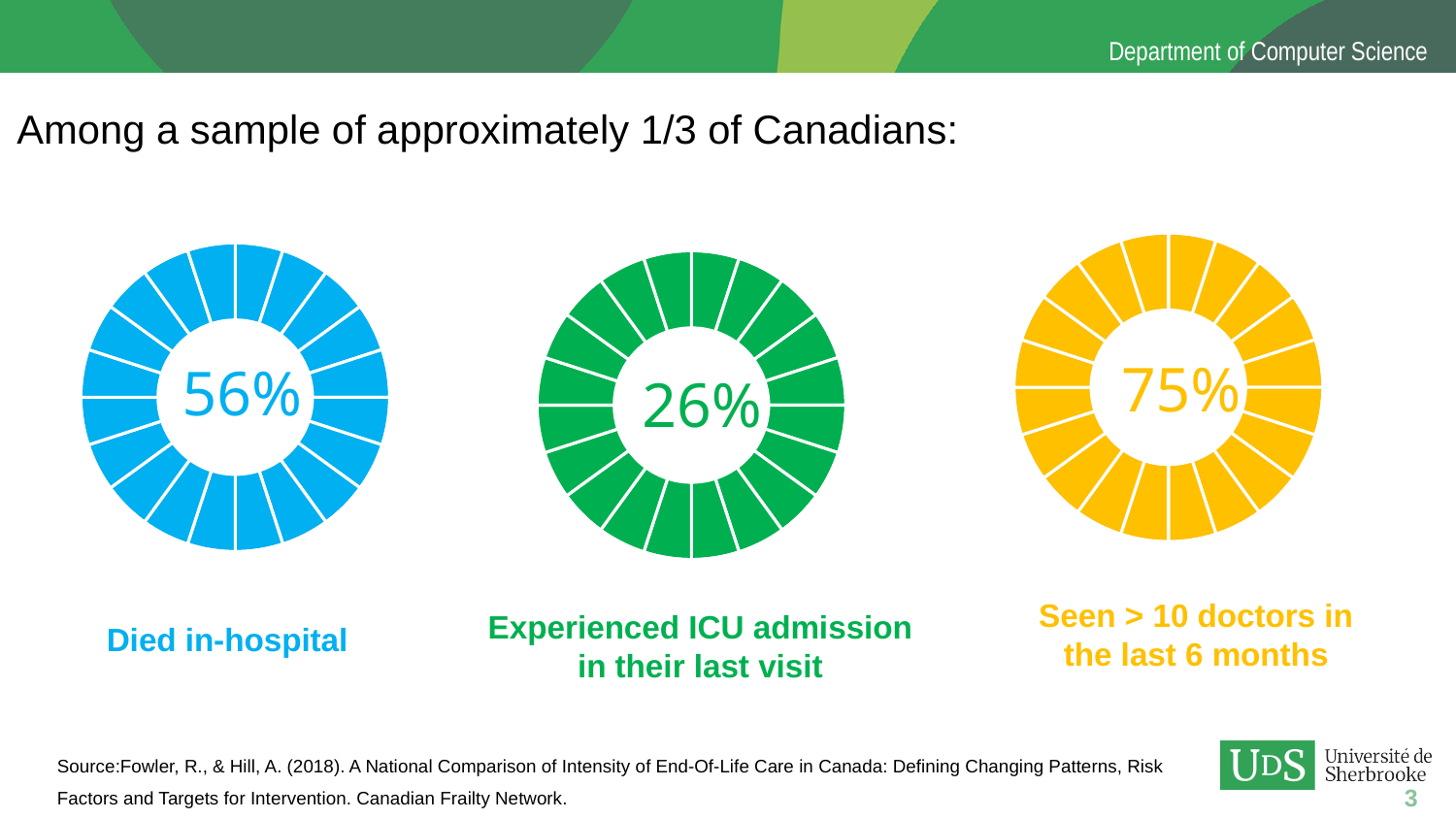
What percentage is shown in the 'Died in-hospital' chart? 56% What percentage is shown in the 'Seen > 10 doctors in the last 6 months' chart? 75% What is the difference between the percentage for 'Died in-hospital' and the percentage for 'Experienced ICU admission in their last visit'? 30% Which of the three charts shows the highest percentage? Seen > 10 doctors in the last 6 months What colour is the 'Died in-hospital' chart? Blue What percentage is shown in the 'Experienced ICU admission in their last visit' chart? 26% What colour is the 'Seen > 10 doctors in the last 6 months' chart? Yellow How many charts are shown on the slide? 3 What is the difference between the percentage for 'Seen > 10 doctors in the last 6 months' and the percentage for 'Died in-hospital'? 19% What kind of chart is used to display the percentages on the slide? Donut chart Which is larger: the percentage for 'Died in-hospital' or the percentage for 'Experienced ICU admission in their last visit'? Died in-hospital Which of the three charts shows the lowest percentage? Experienced ICU admission in their last visit